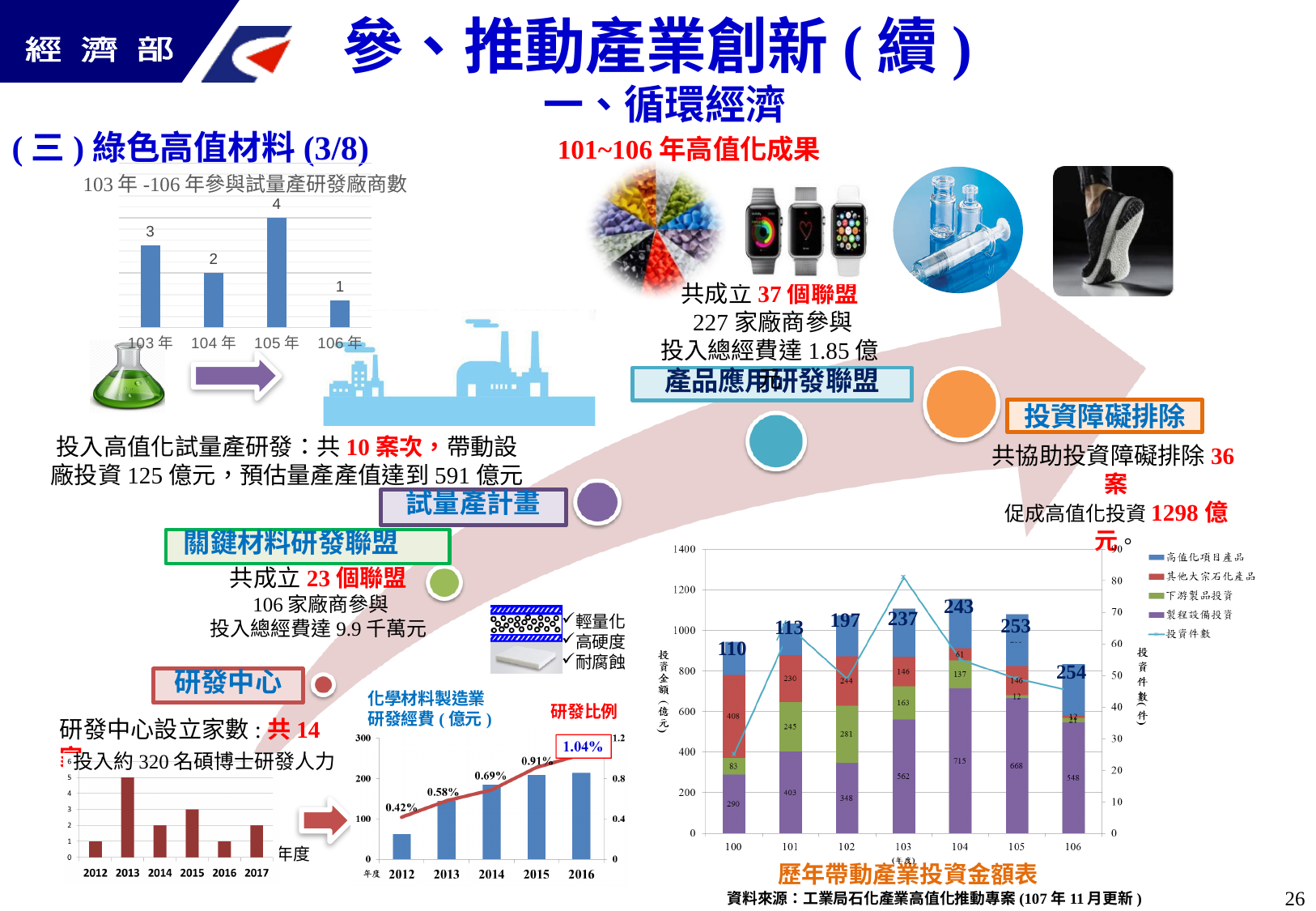
In the chart titled 103年-106年參與試量產研發廠商數, what is the value for 105年? 4 In the bar chart at the bottom left with years 2012 to 2017, which year has the highest bar? 2013 In the chart titled 103年-106年參與試量產研發廠商數, how many years are shown? 4 What kind of chart is the chart titled 103年-106年參與試量產研發廠商數? bar chart In the bar chart at the bottom left with years 2012 to 2017, is the value for 2015 greater or less than 2? greater In the chart titled 103年-106年參與試量產研發廠商數, what is the difference between the values for 105年 and 104年? 2 In the chart titled 化學材料製造業研發經費(億元), does the 研發比例 line rise or fall from 2012 to 2016? rise In the chart titled 103年-106年參與試量產研發廠商數, which year has the lowest value? 106年 In the chart titled 歷年帶動產業投資金額表, how many series does the legend list? 5 In the chart titled 歷年帶動產業投資金額表, what is the 製程設備投資 value for year 104? 715 In the chart titled 化學材料製造業研發經費(億元), what is the 研發比例 value for 2016? 1.04%